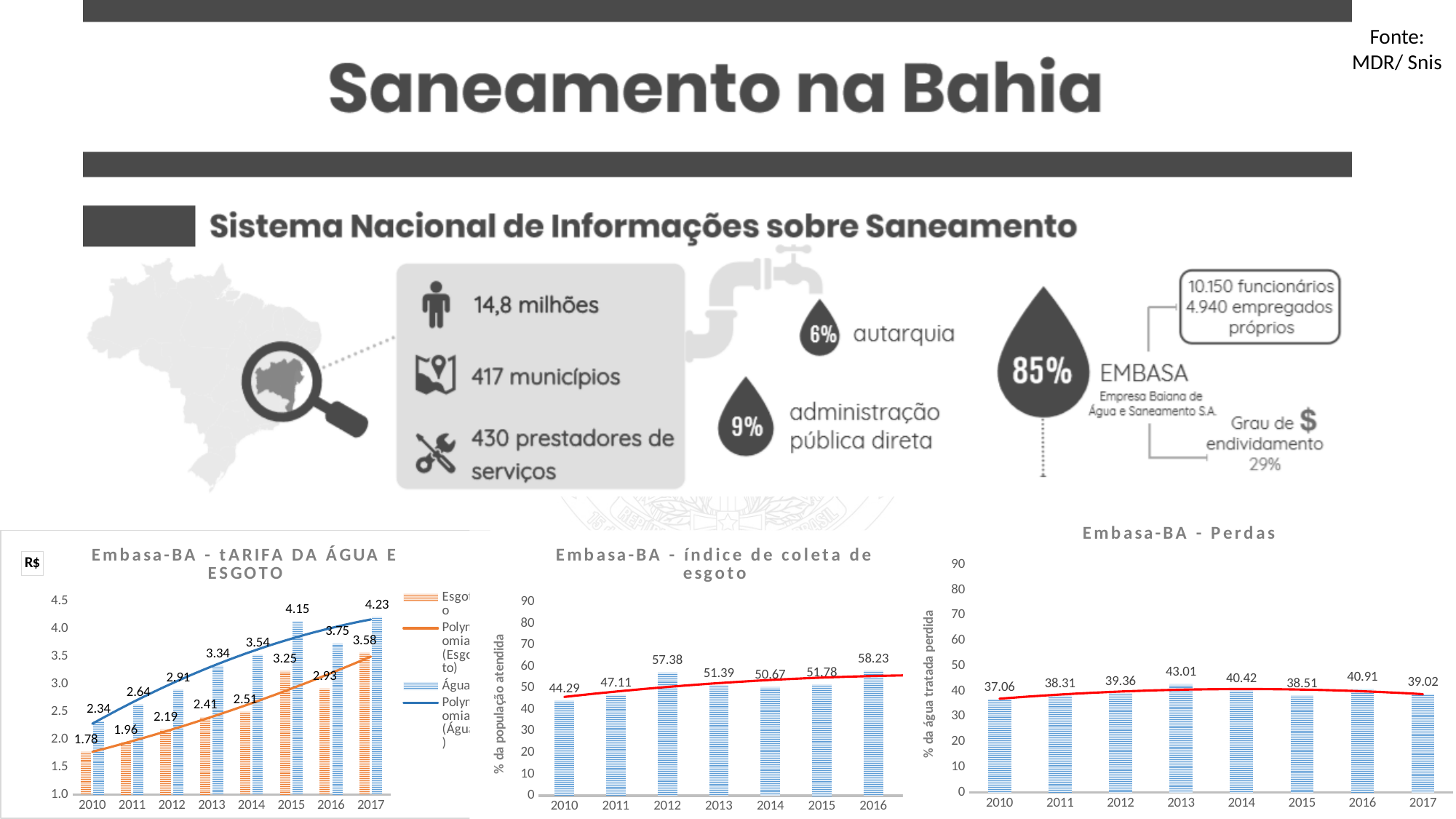
In the 'Embasa-BA - índice de coleta de esgoto' chart, what is the difference between the 2016 value and the 2010 value? 13.94 In the 'Embasa-BA - Perdas' chart, what is the value for 2013? 43.01 In the 'Embasa-BA - Perdas' chart, which year has the highest value? 2013 In the 'Embasa-BA - tARIFA DA ÁGUA E ESGOTO' chart, which is larger in 2015: Água or Esgoto? Água In the 'Embasa-BA - tARIFA DA ÁGUA E ESGOTO' chart, what is the Esgoto value for 2010? 1.78 In the 'Embasa-BA - Perdas' chart, how many years are plotted? 8 In the 'Embasa-BA - índice de coleta de esgoto' chart, which year has the highest value? 2016 In the 'Embasa-BA - Perdas' chart, which year has the lowest value? 2010 What kind of chart is 'Embasa-BA - Perdas'? Bar chart In the 'Embasa-BA - tARIFA DA ÁGUA E ESGOTO' chart, what is the Água value for 2017? 4.23 In the 'Embasa-BA - índice de coleta de esgoto' chart, what is the value for 2012? 57.38 In the 'Embasa-BA - índice de coleta de esgoto' chart, is the value for 2010 greater or less than 50? less